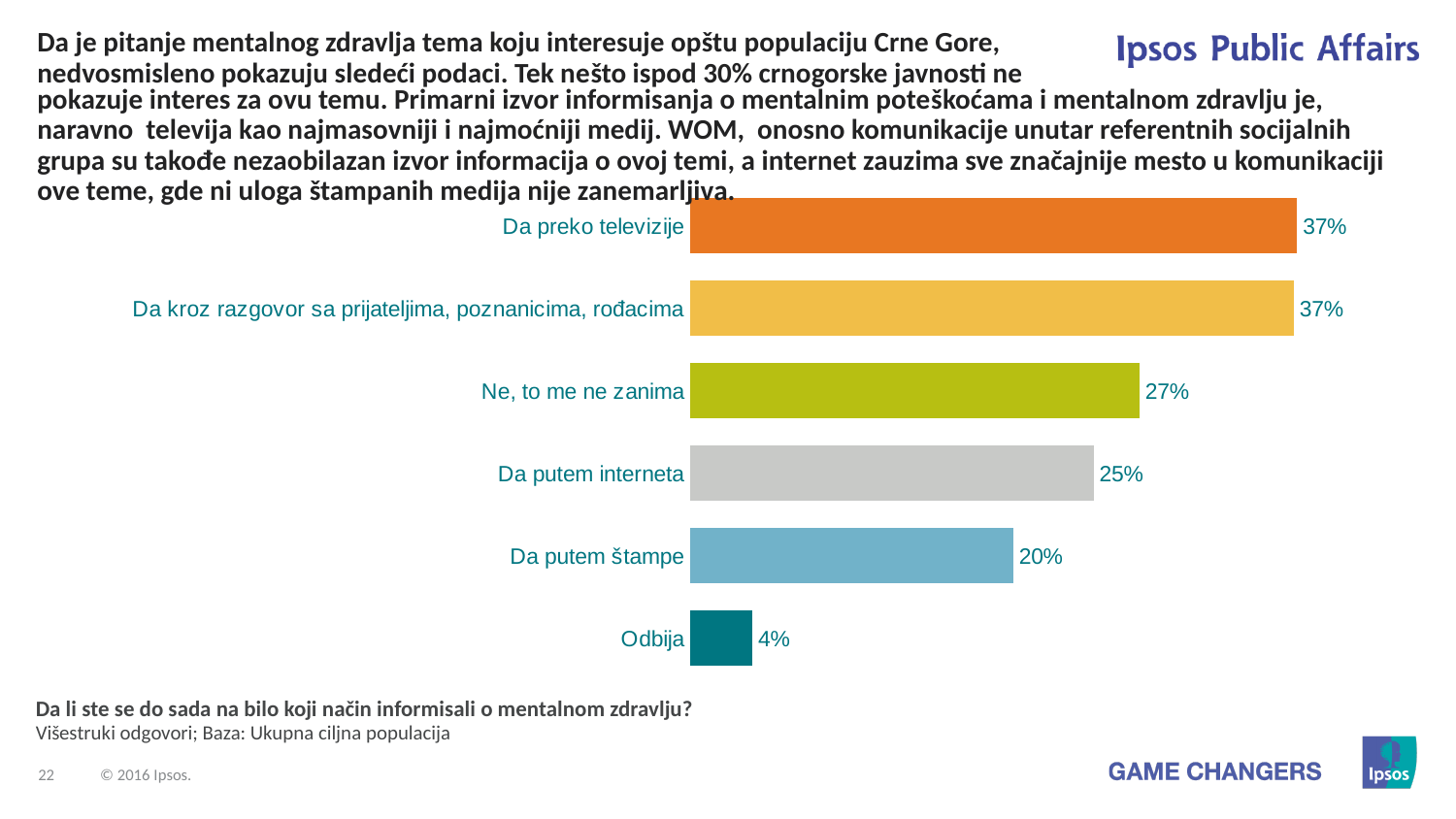
What is the difference between "Ne, to me ne zanima" and "Da putem interneta"? 2% What is the difference between "Da preko televizije" and "Da putem štampe"? 17% Which category has the lowest value? Odbija What kind of chart is shown on the slide? Bar chart How many categories are shown in the chart? 6 What is the value for "Da putem interneta"? 25% What is the difference between "Da kroz razgovor sa prijateljima, poznanicima, rođacima" and "Odbija"? 33% What is the value for "Da putem štampe"? 20% What percentage is shown for "Ne, to me ne zanima"? 27% What is the value for "Odbija"? 4% What percentage is shown for "Da preko televizije"? 37% Which is larger, the value for "Da putem interneta" or the value for "Da putem štampe"? Da putem interneta